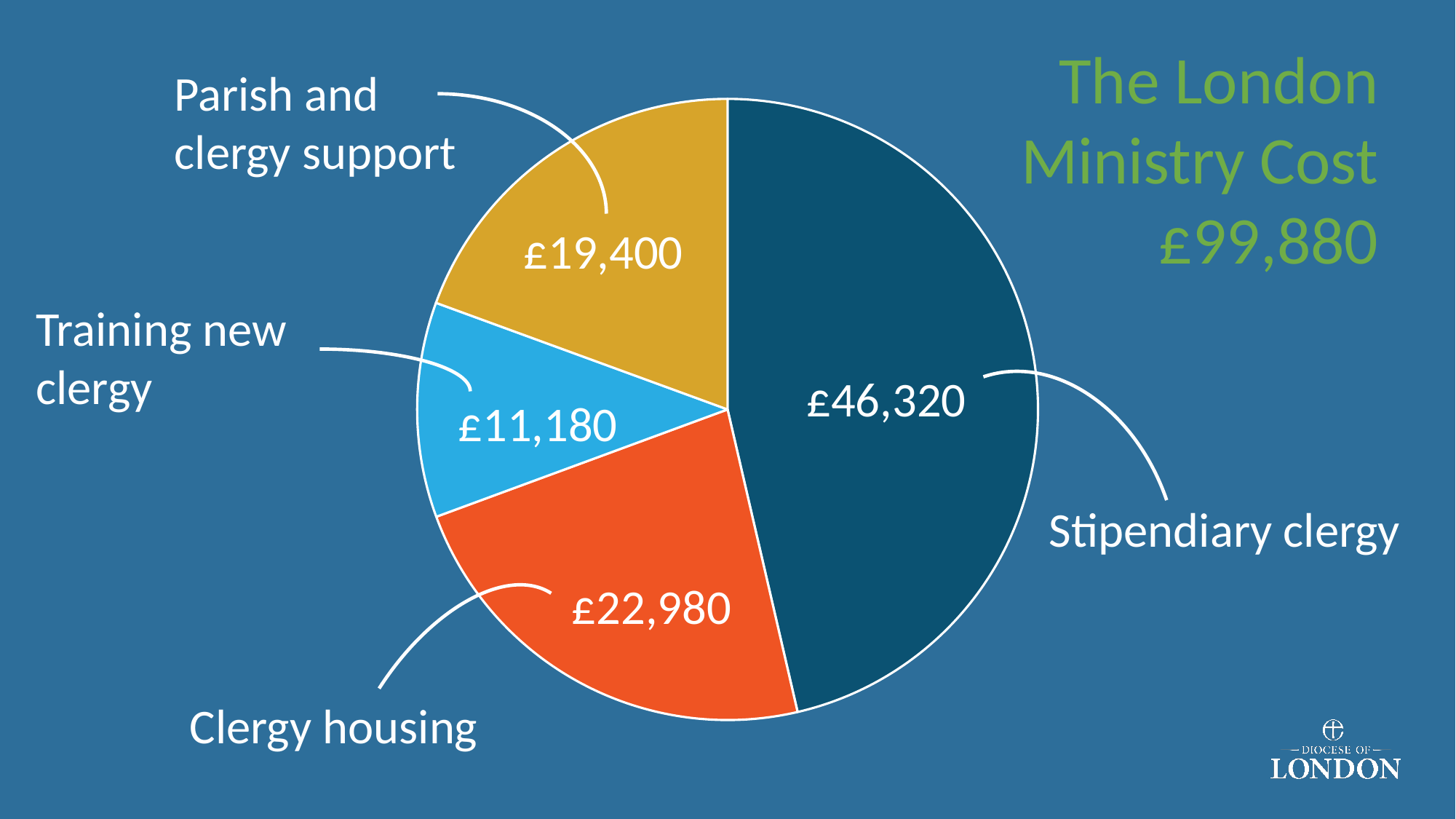
Which category has the largest slice of the pie? Stipendiary clergy What is the value for Parish and clergy support? £19,400 What kind of chart is shown on the slide? Pie chart What total cost is stated in the chart title? £99,880 What is the difference between the Parish and clergy support value and the Training new clergy value? £8,220 Which category has the smallest slice of the pie? Training new clergy What is the value for Stipendiary clergy? £46,320 Which is larger, Clergy housing or Parish and clergy support? Clergy housing What is the value for Training new clergy? £11,180 What is the value for Clergy housing? £22,980 What is the difference between the Stipendiary clergy value and the Clergy housing value? £23,340 How many categories are shown in the pie chart? 4